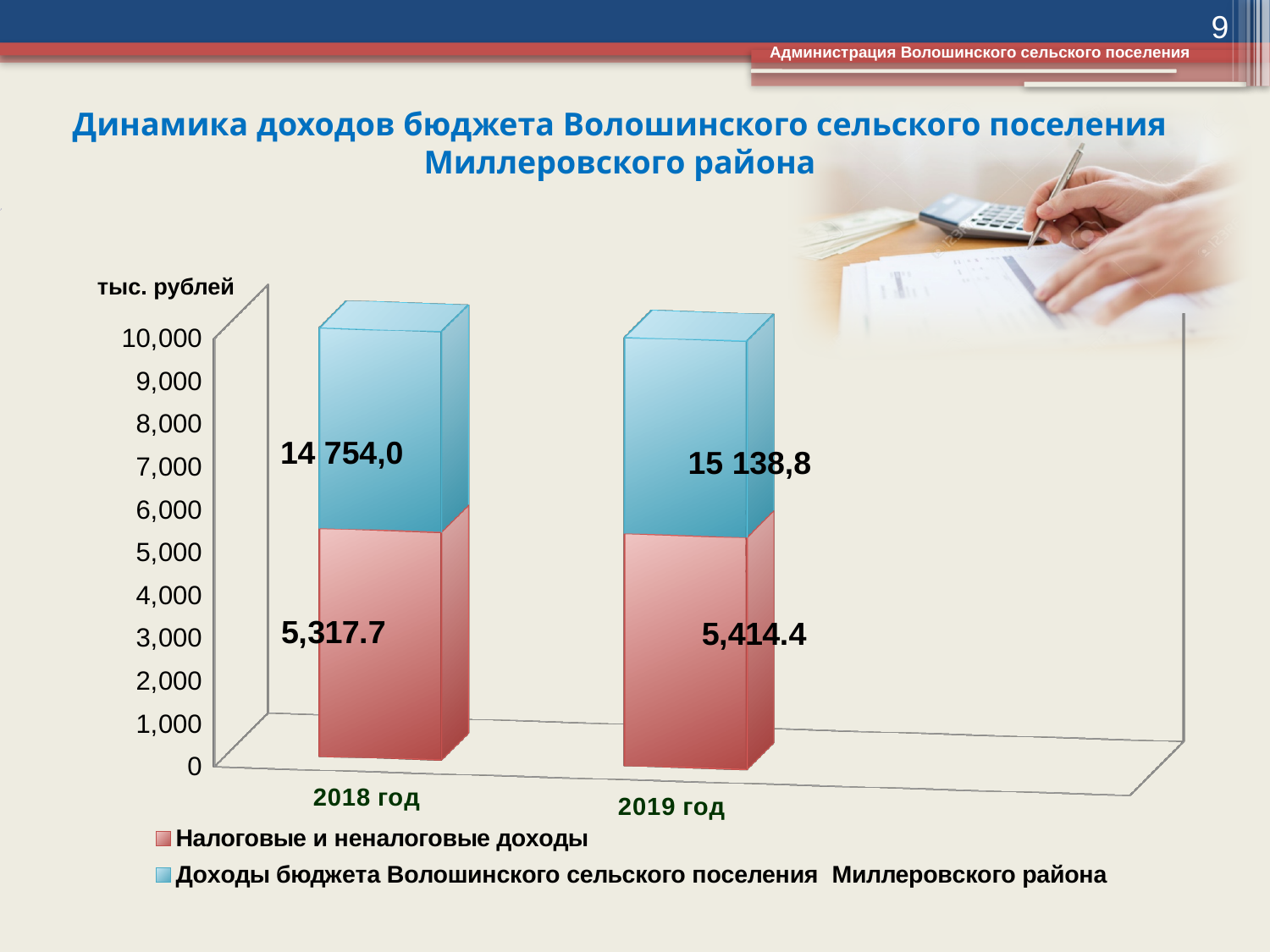
What is the difference between the blue-segment labels for 2019 год and 2018 год? 384,8 How many series does the legend list? 2 What value is labelled on the blue segment (Доходы бюджета Волошинского сельского поселения Миллеровского района) for 2018 год? 14 754,0 Is the Налоговые и неналоговые доходы value for 2018 год larger or smaller than the value for 2019 год? smaller What kind of chart is shown on the slide? stacked bar chart By how much does Налоговые и неналоговые доходы in 2019 год exceed that in 2018 год? 96.7 What is the value of Налоговые и неналоговые доходы for 2019 год? 5,414.4 Which year has the higher value for Налоговые и неналоговые доходы? 2019 год How many years (categories) are shown on the x axis? 2 What unit label is shown above the vertical axis? тыс. рублей What is the value of Налоговые и неналоговые доходы for 2018 год? 5,317.7 What value is labelled on the blue segment (Доходы бюджета Волошинского сельского поселения Миллеровского района) for 2019 год? 15 138,8